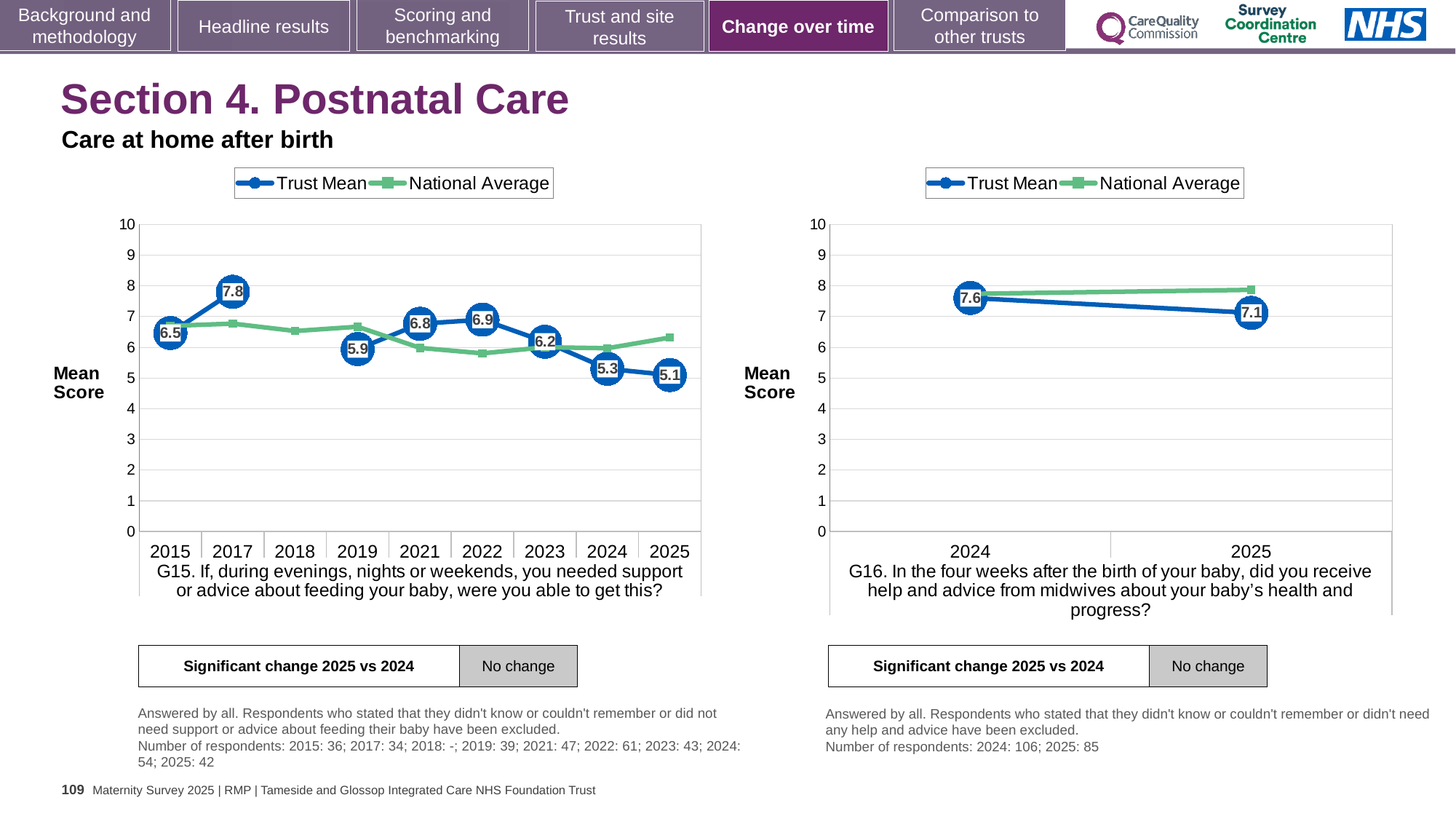
In the right chart (G16), what is the Trust Mean for 2024? 7.6 How many series does the legend of the right chart (G16) list? 2 In the left chart (G15), what is the Trust Mean for 2017? 7.8 In the left chart (G15), which year has the highest Trust Mean? 2017 In the left chart (G15), how many years are shown on the x axis? 9 In the right chart (G16), does the Trust Mean rise or fall from 2024 to 2025? fall In the left chart (G15), what is the difference between the Trust Mean in 2017 and in 2024? 2.5 In the left chart (G15), is the Trust Mean higher in 2022 or in 2023? 2022 In the left chart (G15), is the National Average for 2025 greater or less than 6? greater In the right chart (G16), what is the difference between the Trust Mean in 2024 and in 2025? 0.5 In the left chart (G15), which year has the lowest Trust Mean? 2025 In the left chart (G15), what is the Trust Mean for 2025? 5.1